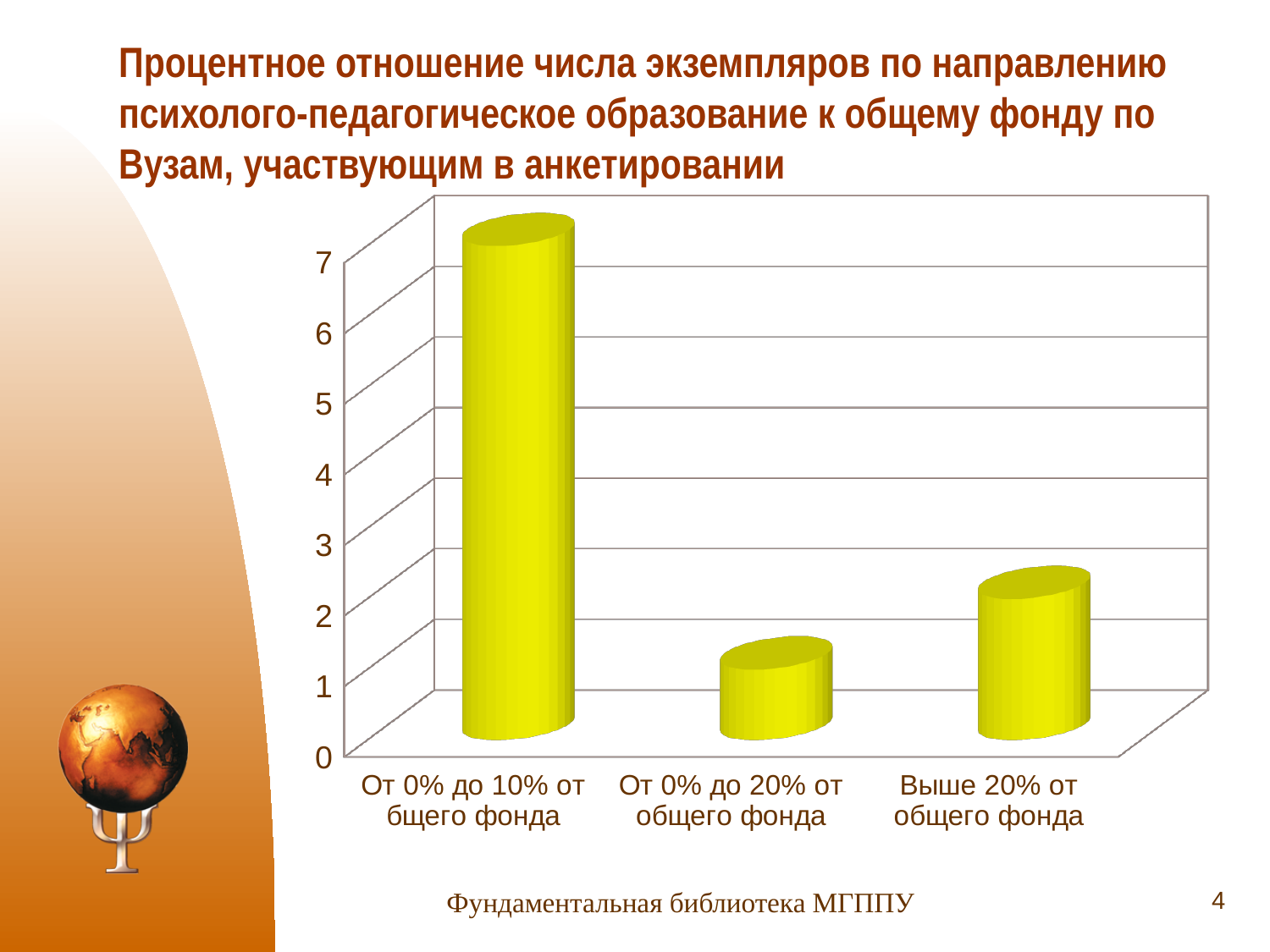
Is the value for "Выше 20% от общего фонда" greater or less than 1? greater What colour are the bars in the chart? yellow Which is larger, the value for "Выше 20% от общего фонда" or the value for "От 0% до 20% от общего фонда"? Выше 20% от общего фонда Is the value for "От 0% до 20% от общего фонда" greater or less than 2? less What is the highest tick value shown on the vertical axis? 7 Which is larger, the value for "От 0% до 10% от бщего фонда" or the value for "Выше 20% от общего фонда"? От 0% до 10% от бщего фонда Is the value for "Выше 20% от общего фонда" greater or less than 3? less Which category has the highest bar? От 0% до 10% от бщего фонда How many categories are plotted on the chart? 3 Which category has the lowest bar? От 0% до 20% от общего фонда What kind of chart is shown on the slide? bar chart